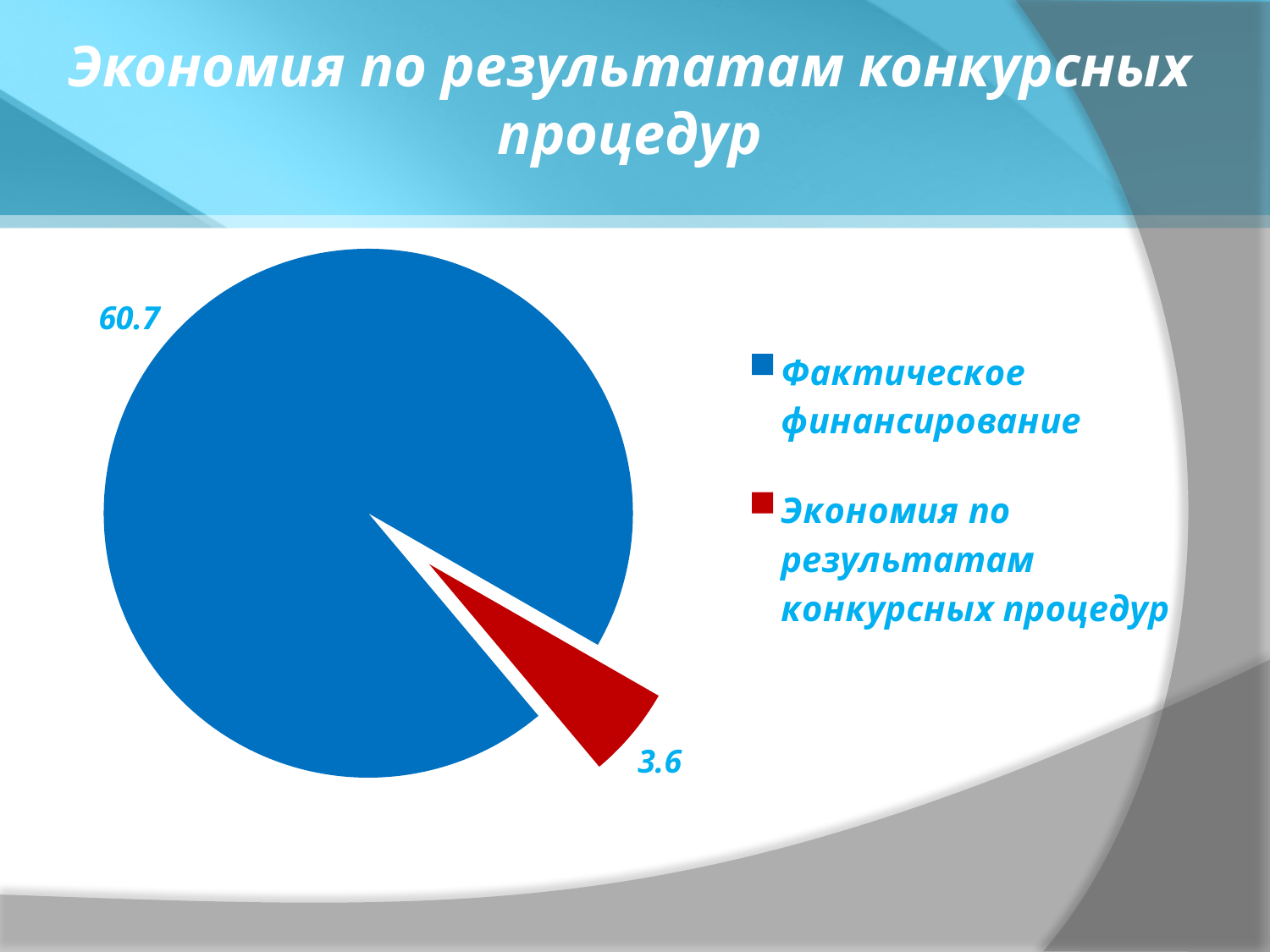
What is the value for Фактическое финансирование? 60.7 How many slices does the pie chart have? 2 What is the total of the two values shown in the pie chart? 64.3 What colour is the slice for Экономия по результатам конкурсных процедур? red Which category has the smallest slice of the pie? Экономия по результатам конкурсных процедур What type of chart is shown on the slide? pie chart What is the difference between the values for Фактическое финансирование and Экономия по результатам конкурсных процедур? 57.1 Which is larger: Фактическое финансирование or Экономия по результатам конкурсных процедур? Фактическое финансирование Which category has the largest slice of the pie? Фактическое финансирование What is the title of the slide? Экономия по результатам конкурсных процедур How many entries does the legend list? 2 What is the value for Экономия по результатам конкурсных процедур? 3.6